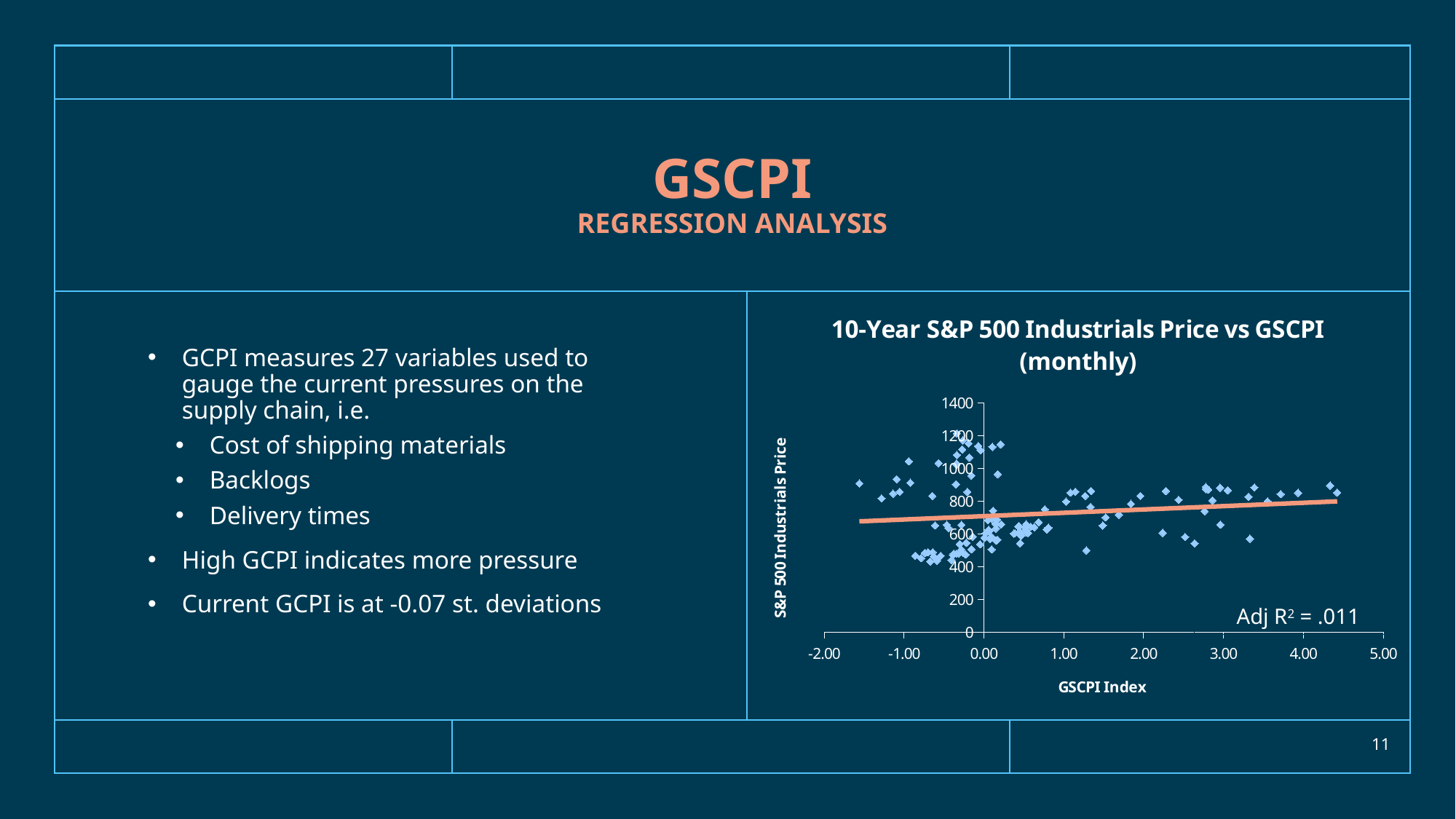
What is the minimum value shown on the x axis of the chart? -2.00 Is the trend line value at a GSCPI Index of -1.00 greater or less than 1000? less What is the maximum value shown on the y axis of the chart? 1400 Is the trend line value at a GSCPI Index of 4.00 greater or less than 600? greater Does the trend line in the chart rise or fall as the GSCPI Index increases? Rises What kind of chart is shown on the slide? Scatter chart What is the maximum value shown on the x axis of the chart? 5.00 What is the title of the chart? 10-Year S&P 500 Industrials Price vs GSCPI (monthly) What Adj R² value is printed on the chart? .011 What is the label of the x axis of the chart? GSCPI Index